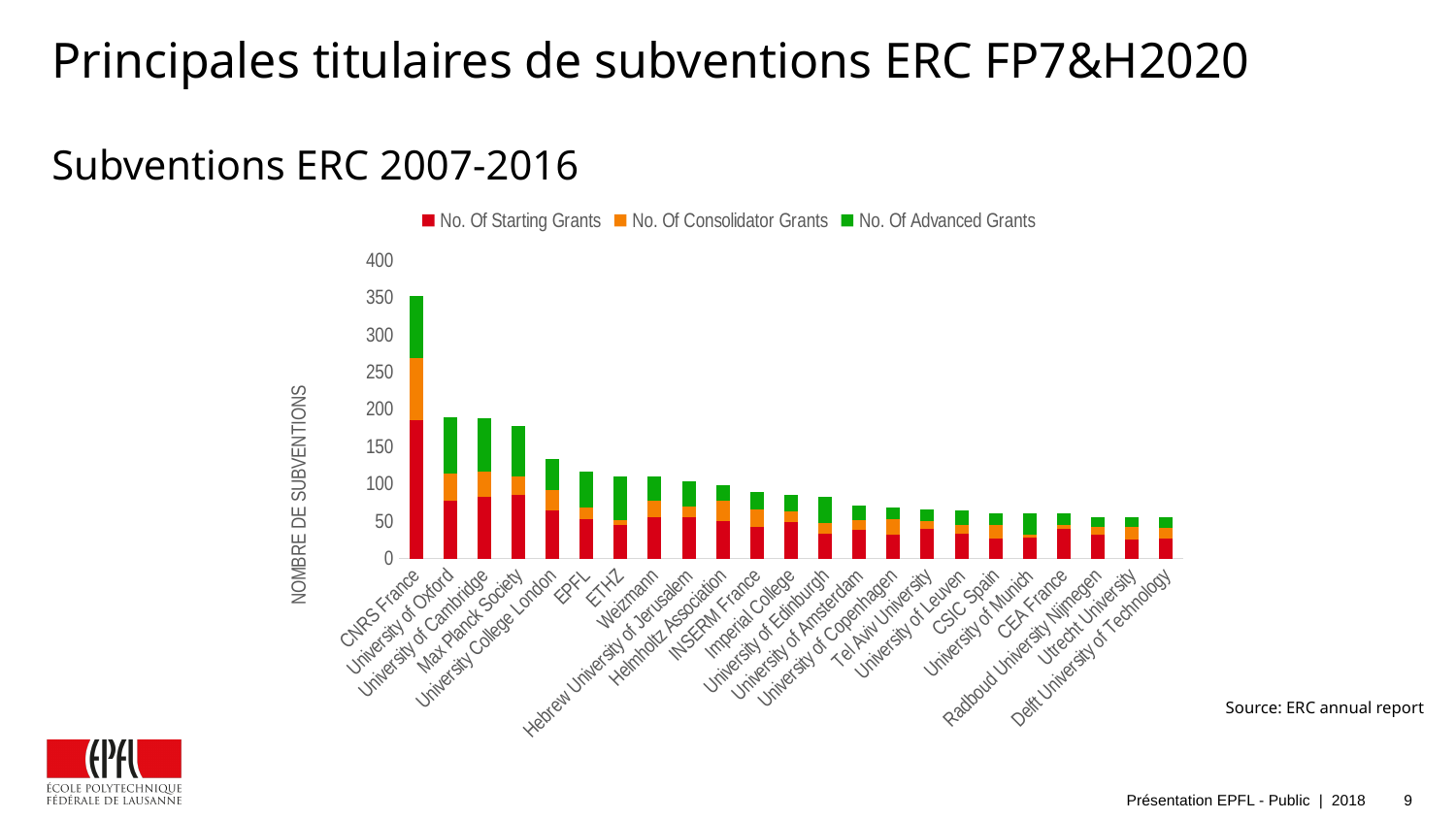
Which institution has the highest total number of ERC grants in the chart? CNRS France Is the total number of grants for University of Oxford greater or less than 200? less Is the total number of grants for Delft University of Technology greater or less than 100? less Is the total number of grants for EPFL greater or less than 100? greater Do the total bar heights rise or fall moving from left to right along the x axis? fall How many series does the legend list? 3 Which has a larger total number of grants, CNRS France or University of Oxford? CNRS France What kind of chart is shown on the slide? Stacked bar chart What is the label of the vertical axis of the chart? NOMBRE DE SUBVENTIONS How many institutions are shown on the x axis of the chart? 23 Which has a larger total number of grants, University of Cambridge or EPFL? University of Cambridge